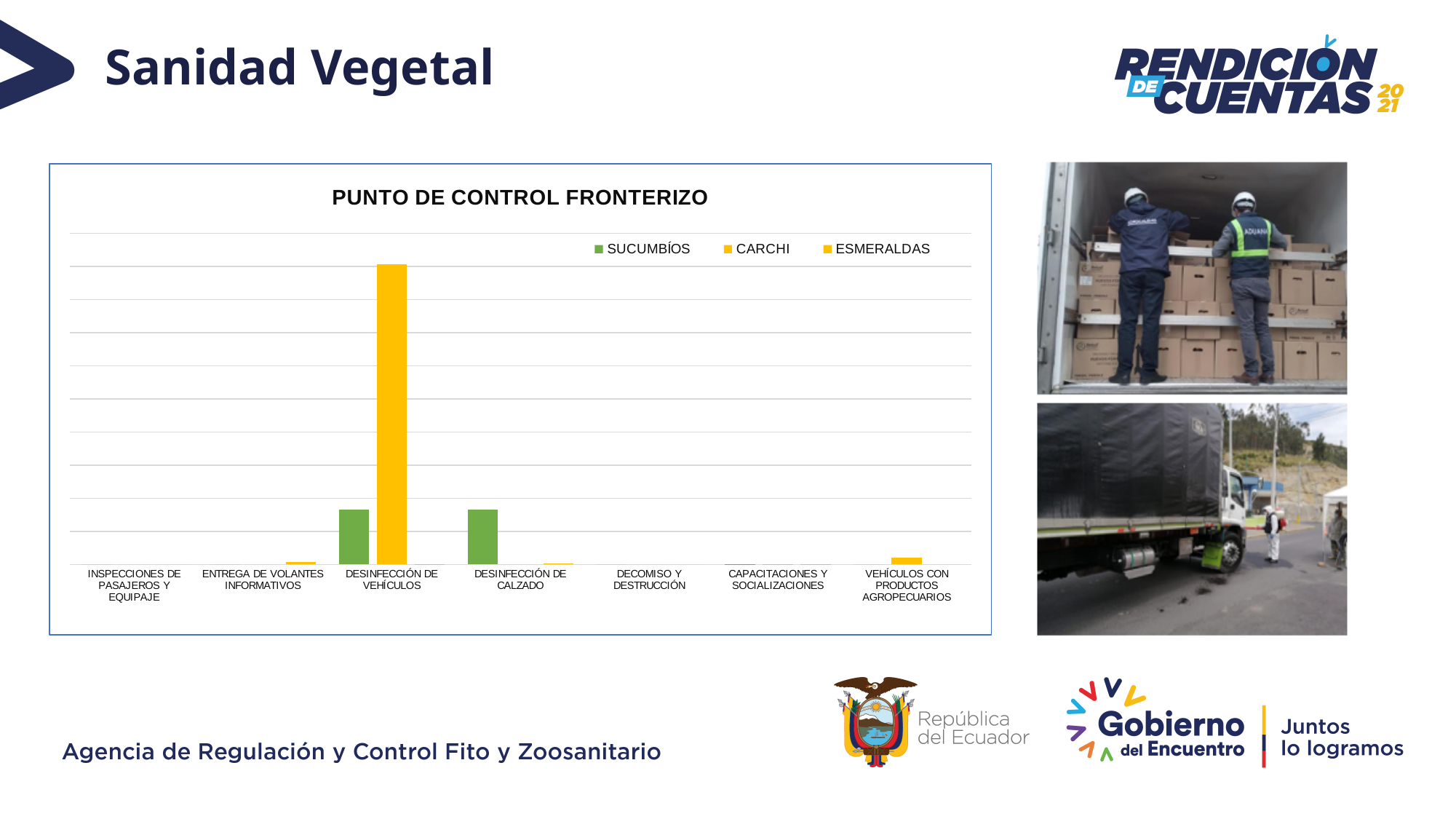
Is the tallest bar for DESINFECCIÓN DE VEHÍCULOS larger or smaller than the bar for ENTREGA DE VOLANTES INFORMATIVOS? Larger Which series is shown in green in the chart's legend? SUCUMBÍOS How many categories are shown along the x axis of the chart? 7 Which category is listed last on the x axis of the chart? VEHÍCULOS CON PRODUCTOS AGROPECUARIOS What kind of chart is shown under the title PUNTO DE CONTROL FRONTERIZO? Bar chart How many series does the legend of the chart list? 3 Is the green SUCUMBÍOS bar for DESINFECCIÓN DE CALZADO larger or smaller than the yellow bar for VEHÍCULOS CON PRODUCTOS AGROPECUARIOS? Larger Which category has the tallest bar in the chart? DESINFECCIÓN DE VEHÍCULOS Which category is listed first on the x axis of the chart? INSPECCIONES DE PASAJEROS Y EQUIPAJE